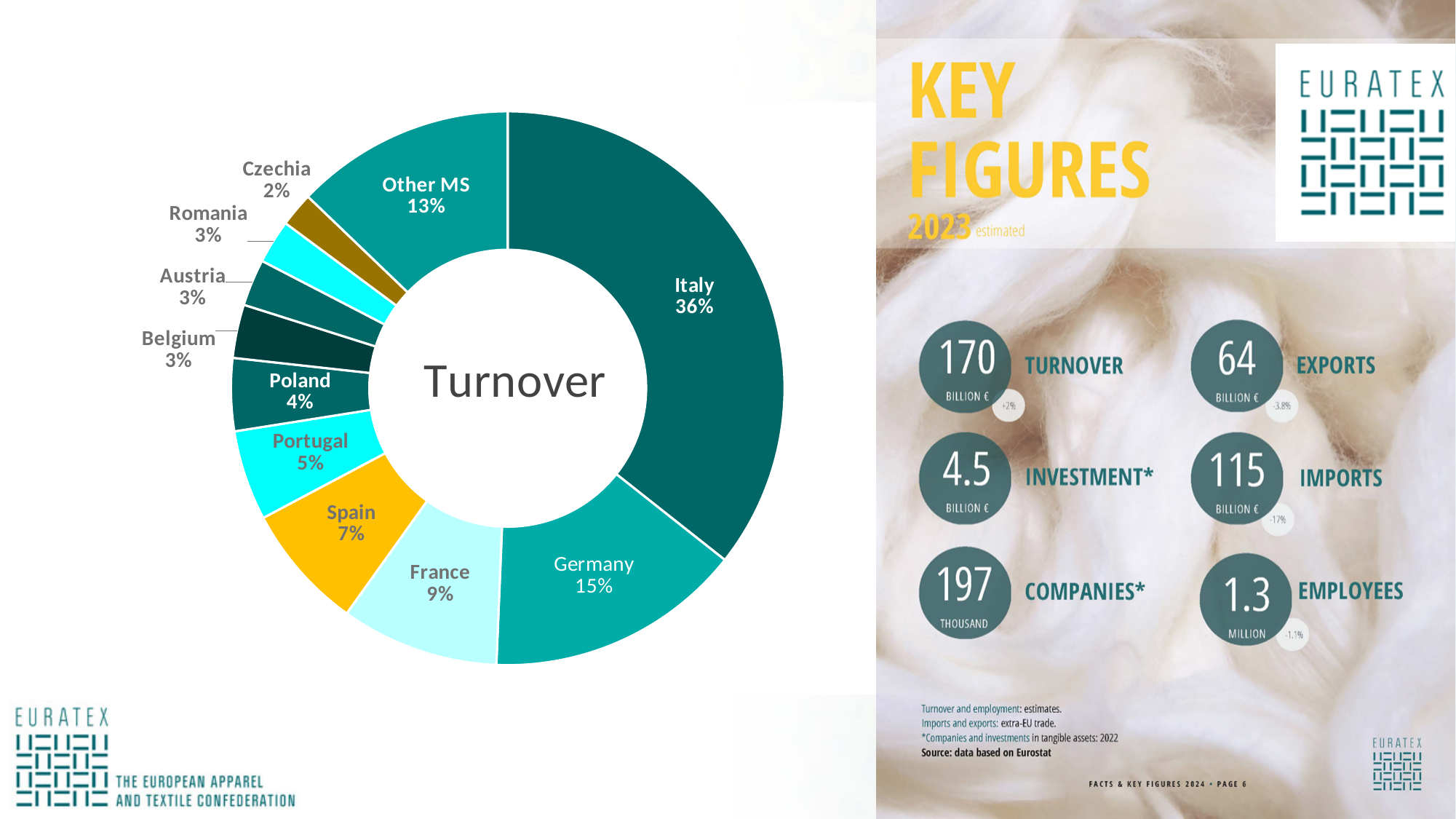
What kind of chart is the Turnover chart? Pie chart (donut) What is the value for Portugal in the Turnover chart? 5% Which country has the largest share in the Turnover chart? Italy How many slices are shown in the Turnover chart? 11 In the Turnover chart, what is the difference in percentage points between France and Spain? 2 Which category has the smallest share in the Turnover chart? Czechia What is the value shown for Germany in the Turnover chart? 15% What share of turnover does Italy account for in the Turnover chart? 36% In the Turnover chart, what is the difference in percentage points between Italy and Germany? 21 What percentage is shown for Other MS in the Turnover chart? 13% In the Turnover chart, which has a larger share, Spain or Poland? Spain What word is written in the centre of the pie chart? Turnover